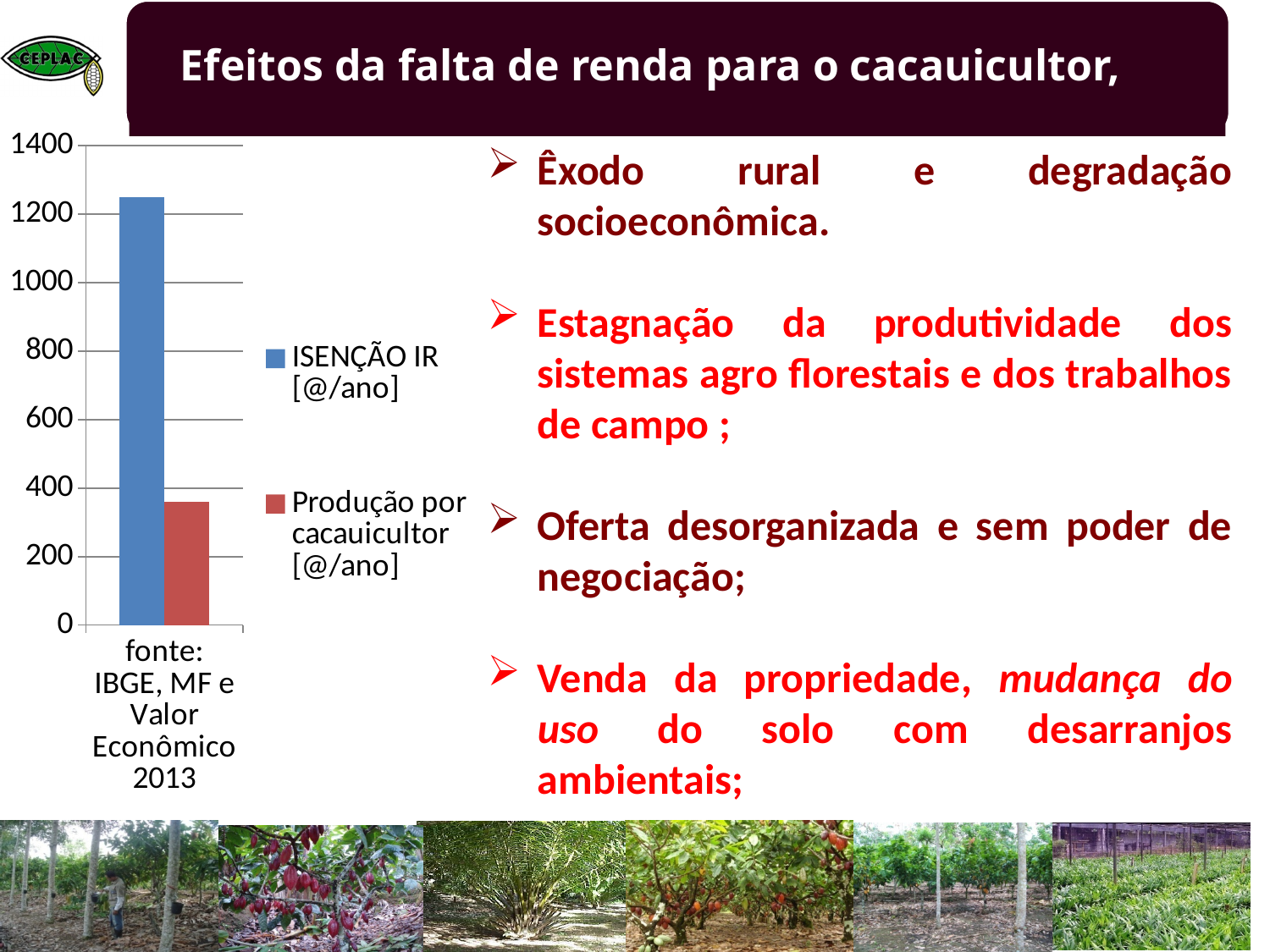
How many categories are shown on the horizontal axis of the chart? 1 Which series has the lowest value in the chart? Produção por cacauicultor [@/ano] What colour is the bar for ISENÇÃO IR [@/ano]? blue Which series has the highest value in the chart? ISENÇÃO IR [@/ano] Is the value for Produção por cacauicultor [@/ano] greater or less than 200? greater What is the maximum value shown on the vertical axis of the chart? 1400 Is the value for ISENÇÃO IR [@/ano] greater or less than 1400? less Is the value for Produção por cacauicultor [@/ano] greater or less than 400? less What kind of chart is shown on the slide? bar chart How many series does the chart legend list? 2 Which series has the taller bar, ISENÇÃO IR [@/ano] or Produção por cacauicultor [@/ano]? ISENÇÃO IR [@/ano]